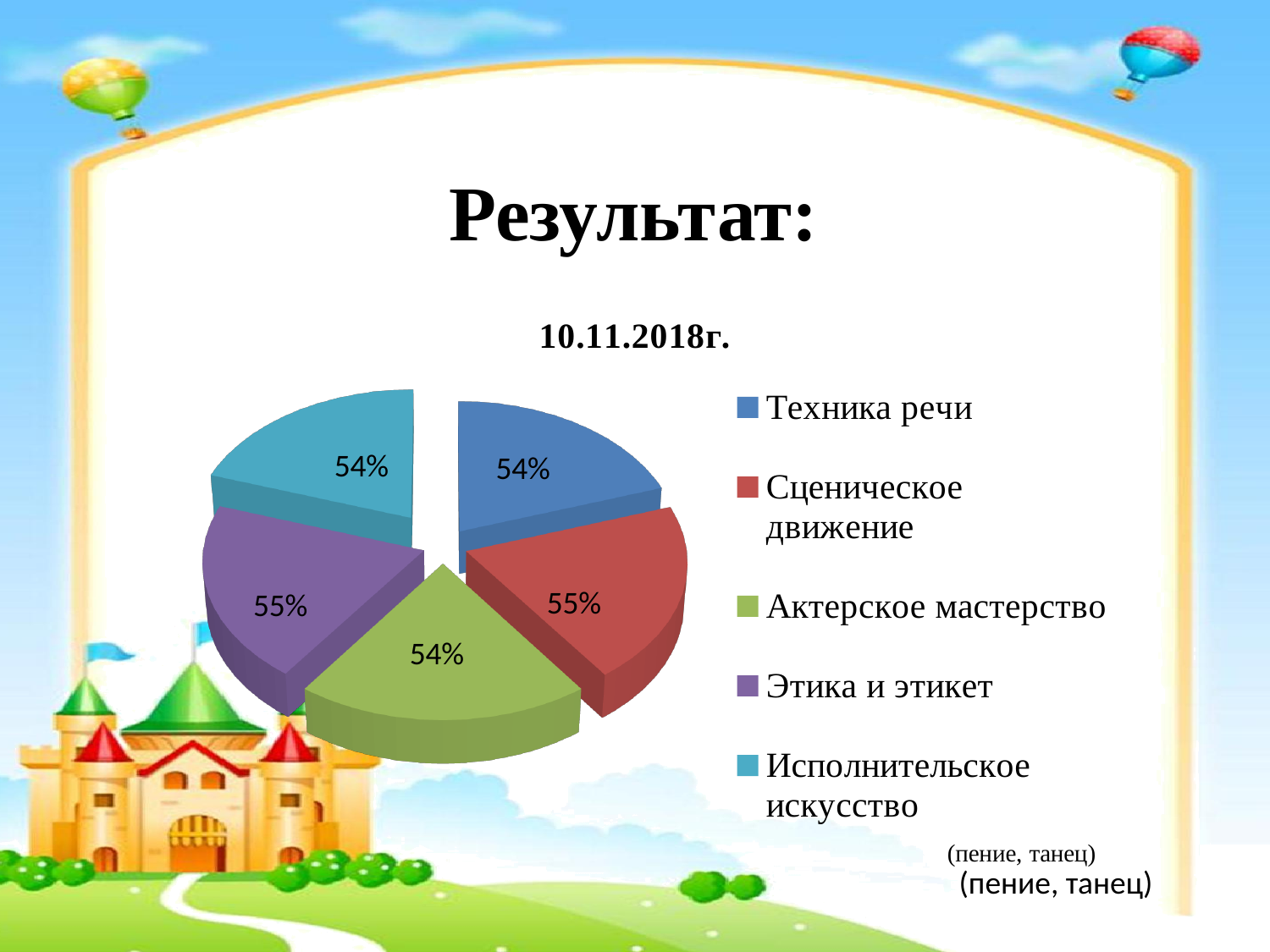
Which colour represents Актерское мастерство in the pie chart? Green What value is shown for Этика и этикет? 55% What is the difference between the values for Сценическое движение and Техника речи? 1% What value is shown for Исполнительское искусство? 54% What value is shown for Техника речи? 54% What value is shown for Актерское мастерство? 54% What value is shown for Сценическое движение? 55% What type of chart is shown on the slide? Pie chart How many slices does the pie chart have? 5 How many entries does the chart legend list? 5 What is the difference between the values for Этика и этикет and Актерское мастерство? 1% What is the title of the chart? 10.11.2018г.